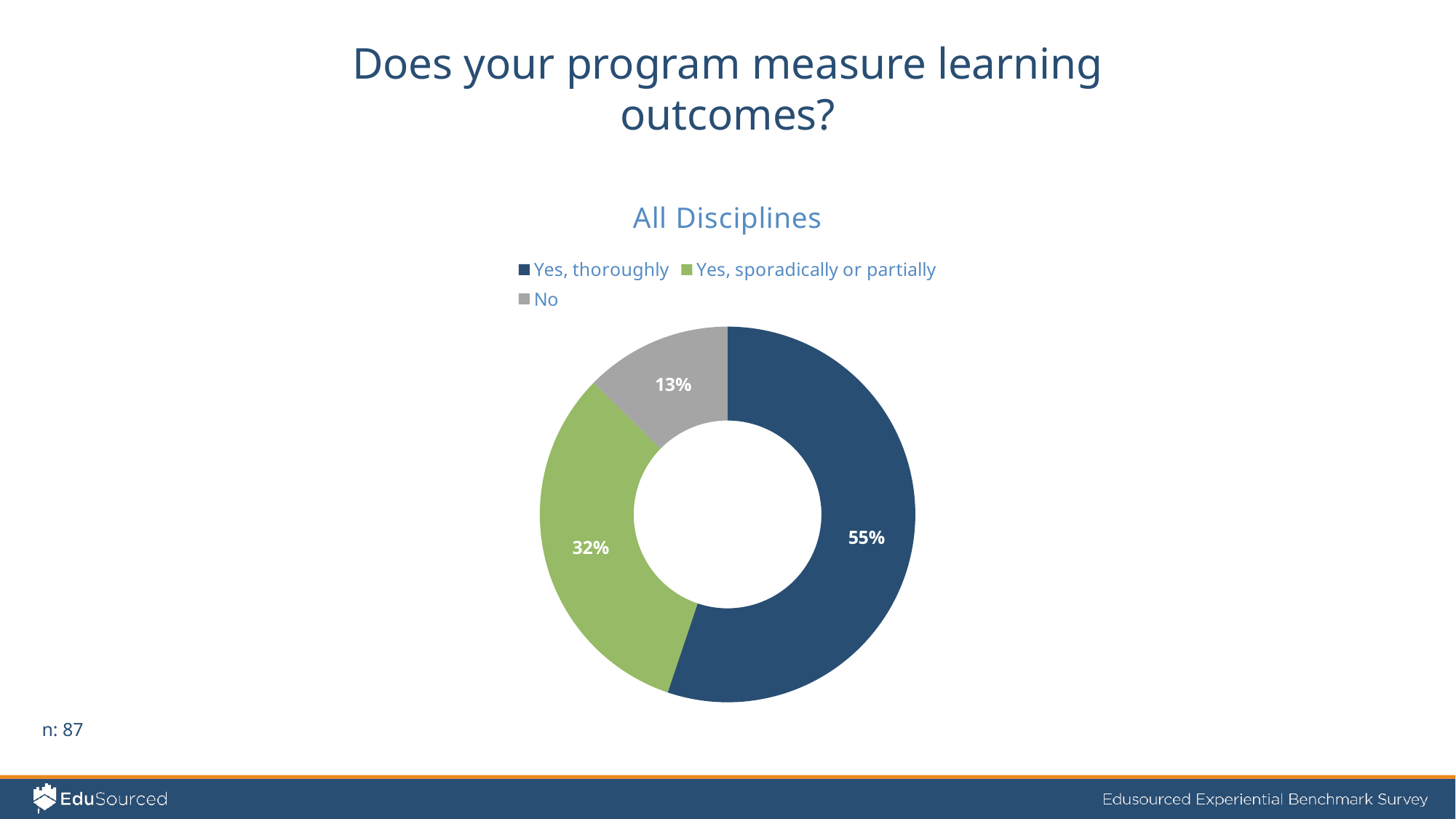
What is the title of the chart? All Disciplines What percentage of respondents answered "No"? 13% Which response has the largest share of the chart? Yes, thoroughly What is the difference in percentage points between "Yes, sporadically or partially" and "No"? 19 What percentage of respondents answered "Yes, thoroughly"? 55% What colour represents the "No" category in the chart? Grey What kind of chart is shown on the slide? Pie chart (doughnut) How many categories does the chart show? 3 What is the difference in percentage points between "Yes, thoroughly" and "Yes, sporadically or partially"? 23 Which response has the smallest share of the chart? No Which is larger: the share for "Yes, sporadically or partially" or the share for "No"? Yes, sporadically or partially What percentage of respondents answered "Yes, sporadically or partially"? 32%